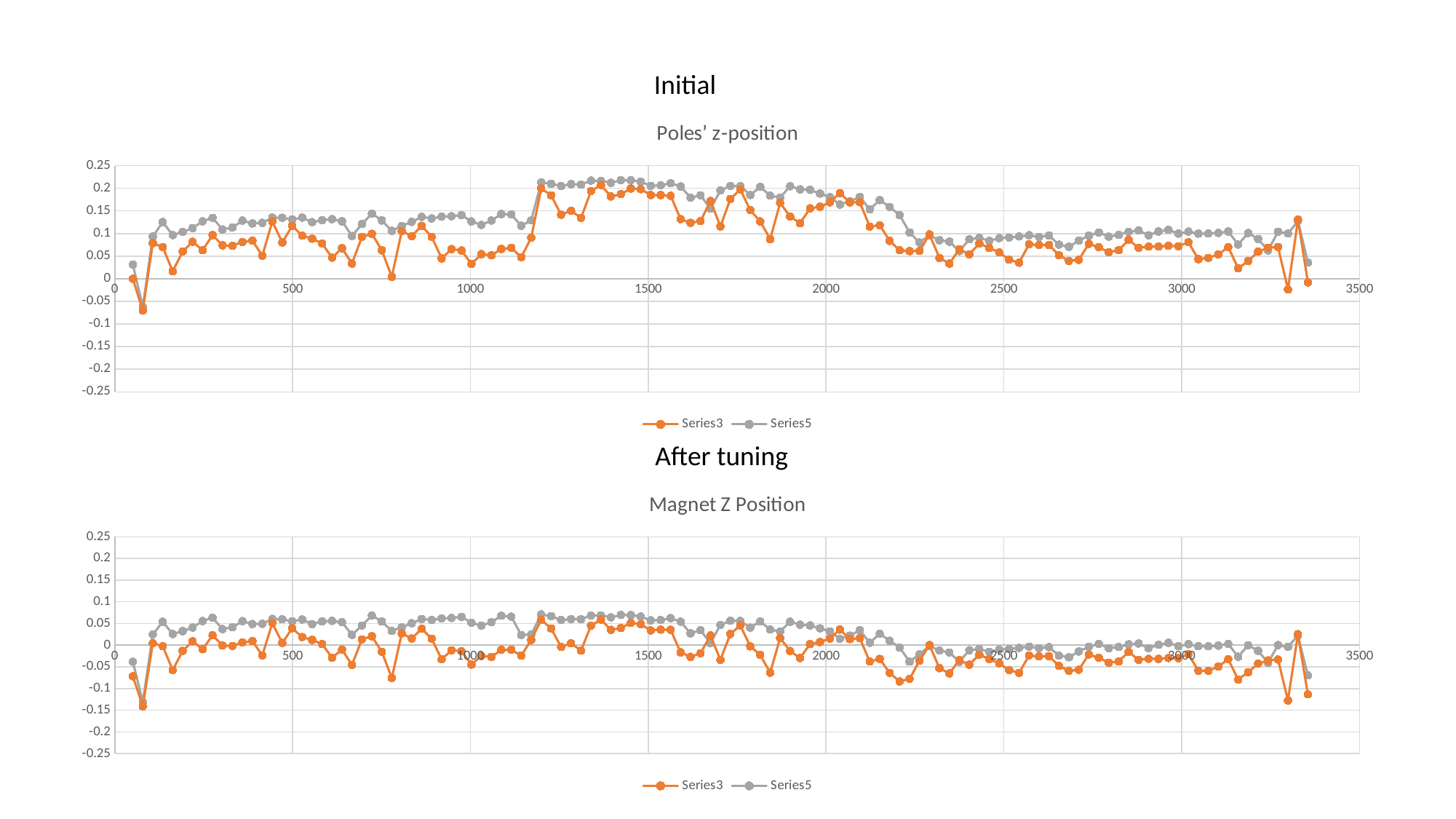
In the top chart "Poles' z-position", is the highest value of Series5 greater or less than 0.25? less In the bottom chart "Magnet Z Position", is the highest value of Series5 greater or less than 0.1? less What is the maximum value shown on the vertical axis of the bottom chart "Magnet Z Position"? 0.25 In the top chart "Poles' z-position", do the Series5 values rise or fall between x=2000 and x=2300? fall What are the names of the series in the legend of the bottom chart "Magnet Z Position"? Series3 and Series5 What kind of chart is the top chart titled "Poles' z-position"? line chart How many series does the legend of the top chart "Poles' z-position" list? 2 In the top chart "Poles' z-position", which series is plotted in orange? Series3 In the top chart "Poles' z-position", which series generally has the higher values, Series3 or Series5? Series5 In the bottom chart "Magnet Z Position", is the lowest value of Series3 near x=100 greater or less than -0.1? less